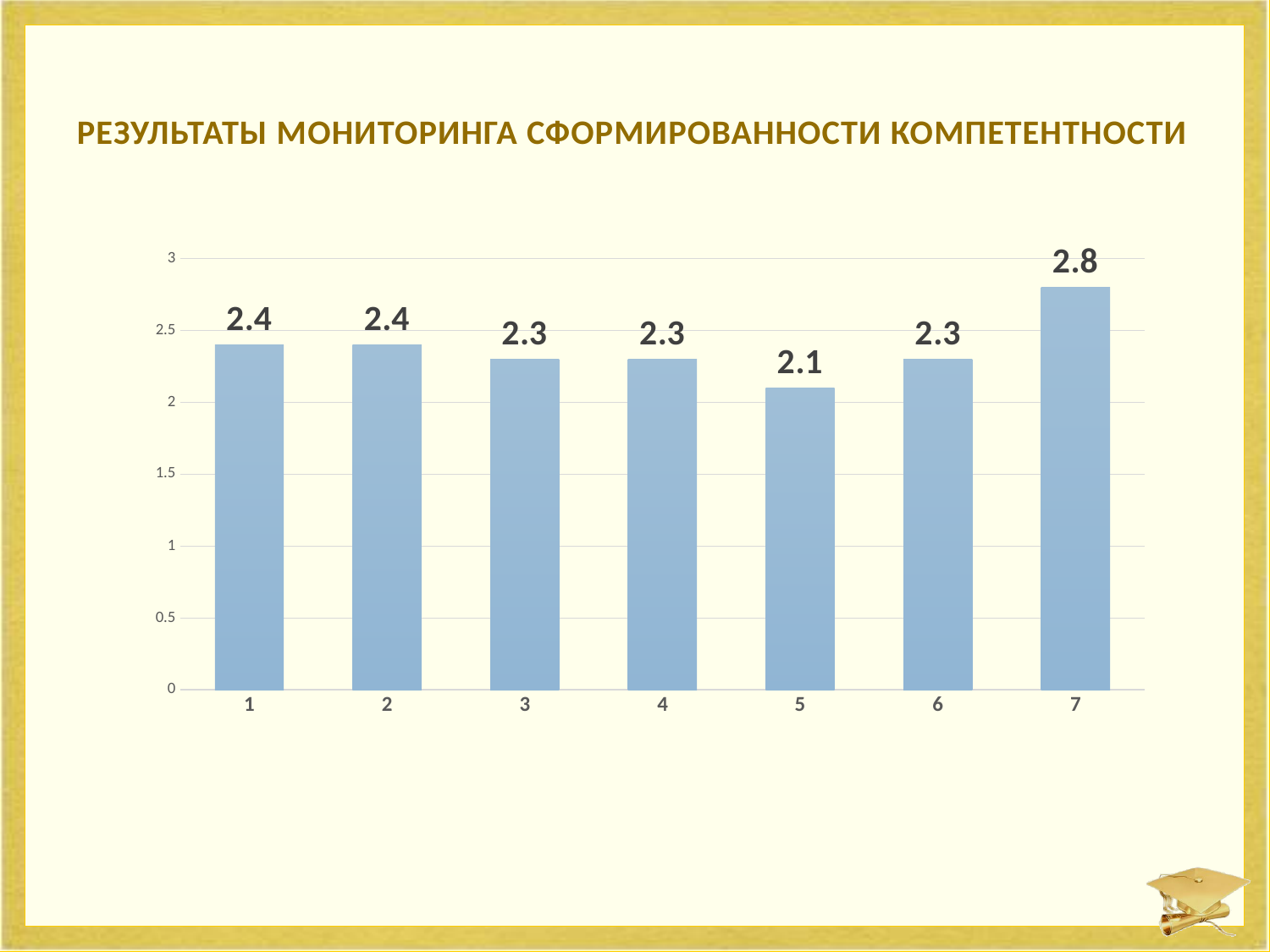
What is the value for category 5? 2.1 Is the value for category 7 greater or less than 2.5? greater What is the difference between the values for category 1 and category 6? 0.1 What is the value for category 7? 2.8 Which is larger, the value for category 2 or the value for category 3? category 2 How many categories are shown on the x axis? 7 Which category has the lowest value? 5 What is the title of the slide? РЕЗУЛЬТАТЫ МОНИТОРИНГА СФОРМИРОВАННОСТИ КОМПЕТЕНТНОСТИ Which category has the highest value? 7 What is the value for category 1? 2.4 What is the difference between the values for category 7 and category 5? 0.7 What kind of chart is shown on the slide? bar chart